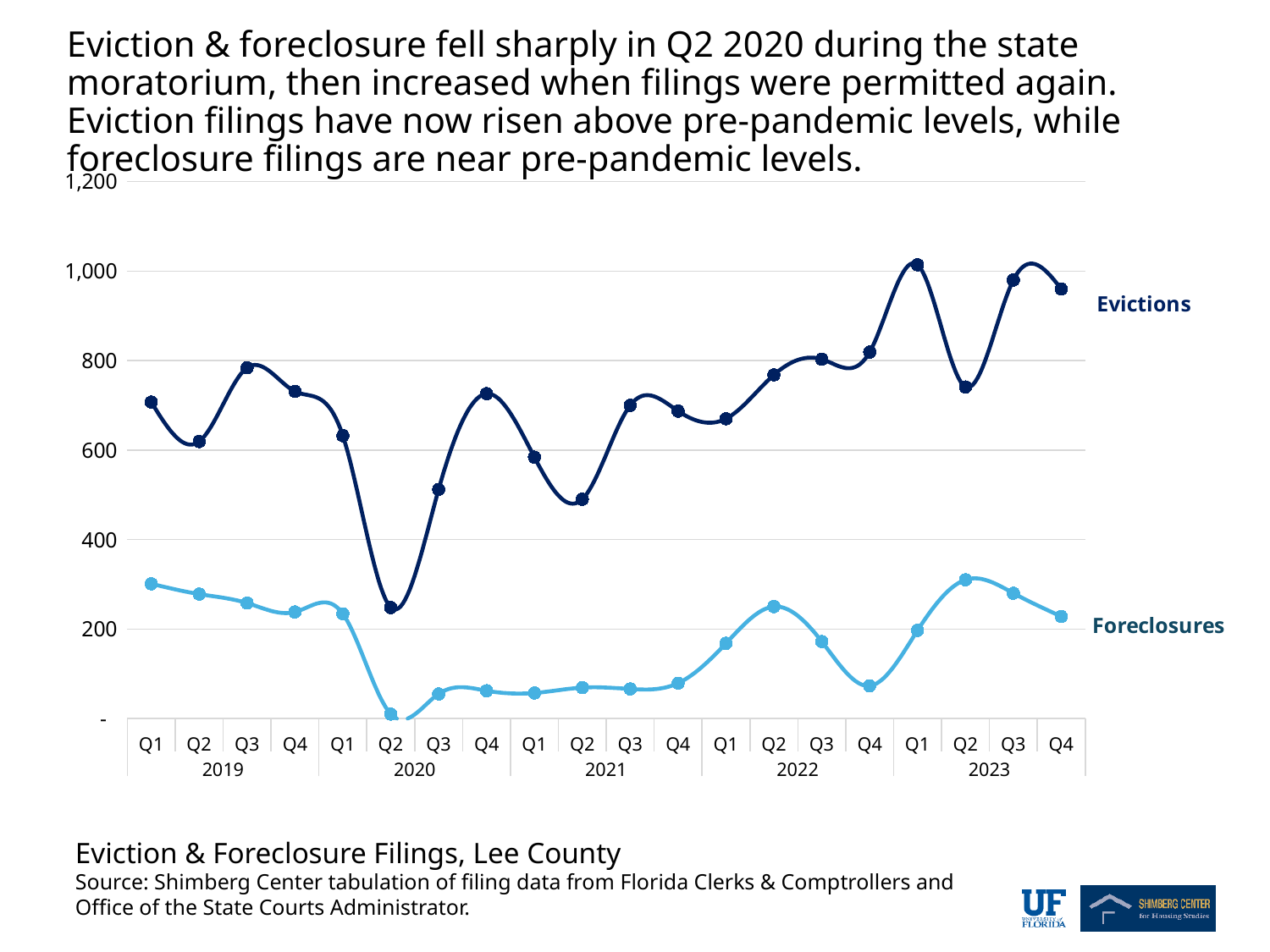
Is the value for Evictions in Q2 2020 greater or less than 400? less How many quarterly data points does each line have? 20 How many series does the chart show? 2 Is the value for Evictions in Q1 2023 greater or less than 800? greater What kind of chart is shown on the slide? Line chart Is the value for Foreclosures in Q1 2019 greater or less than 200? greater In which quarter do Foreclosures reach their lowest value? Q2 2020 Which series is higher in Q4 2023, Evictions or Foreclosures? Evictions What is the title of the chart? Eviction & Foreclosure Filings, Lee County Do Foreclosures rise or fall from Q1 2019 to Q2 2020? Fall In which quarter do Evictions reach their lowest value? Q2 2020